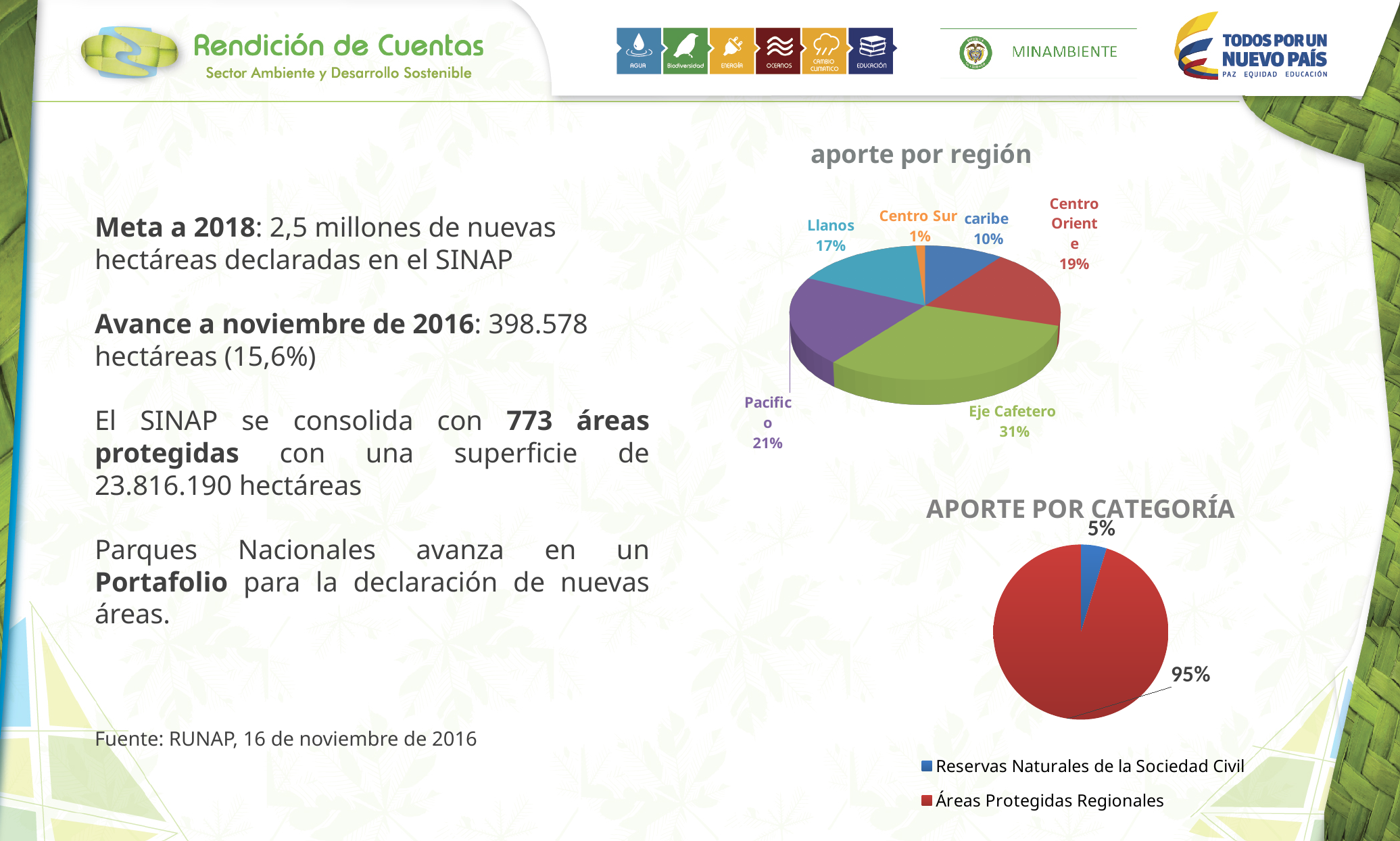
In the 'aporte por región' chart, what share does Pacifico have? 21% What kind of chart is 'aporte por región'? Pie chart In the 'aporte por región' chart, what is the difference between the shares of Eje Cafetero and caribe? 21% In the 'aporte por región' chart, what share does Centro Sur have? 1% How many regions are shown in the 'aporte por región' chart? 6 In the 'aporte por región' chart, which has a larger share, Llanos or Centro Oriente? Centro Oriente In the 'APORTE POR CATEGORÍA' chart, what share do Reservas Naturales de la Sociedad Civil have? 5% In the 'APORTE POR CATEGORÍA' chart, what share do Áreas Protegidas Regionales have? 95% In the 'aporte por región' chart, which region has the largest share? Eje Cafetero How many categories does the legend of the 'APORTE POR CATEGORÍA' chart list? 2 In the 'aporte por región' chart, which region has the smallest share? Centro Sur In the 'aporte por región' chart, what share does Eje Cafetero have? 31%